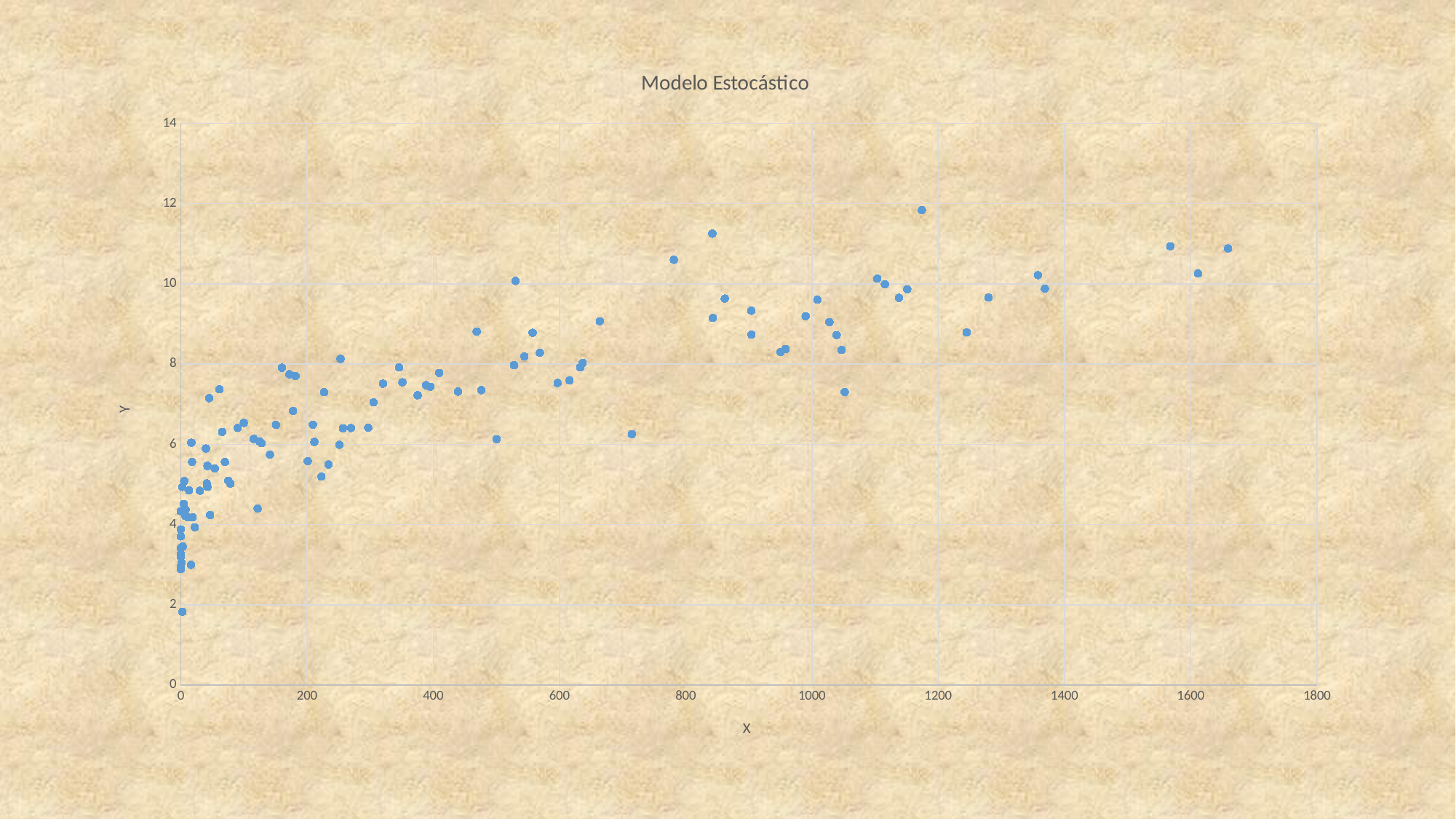
Is the Y value of the highest point greater or less than 12? less What kind of chart is shown on the slide? Scatter chart Is the highest Y value plotted greater or less than 10? greater Are there any points plotted with an X value greater than 1800? No What are the labels of the horizontal and vertical axes? X and Y Do the Y values generally rise or fall as X increases? Rise What is the title of the chart? Modelo Estocástico